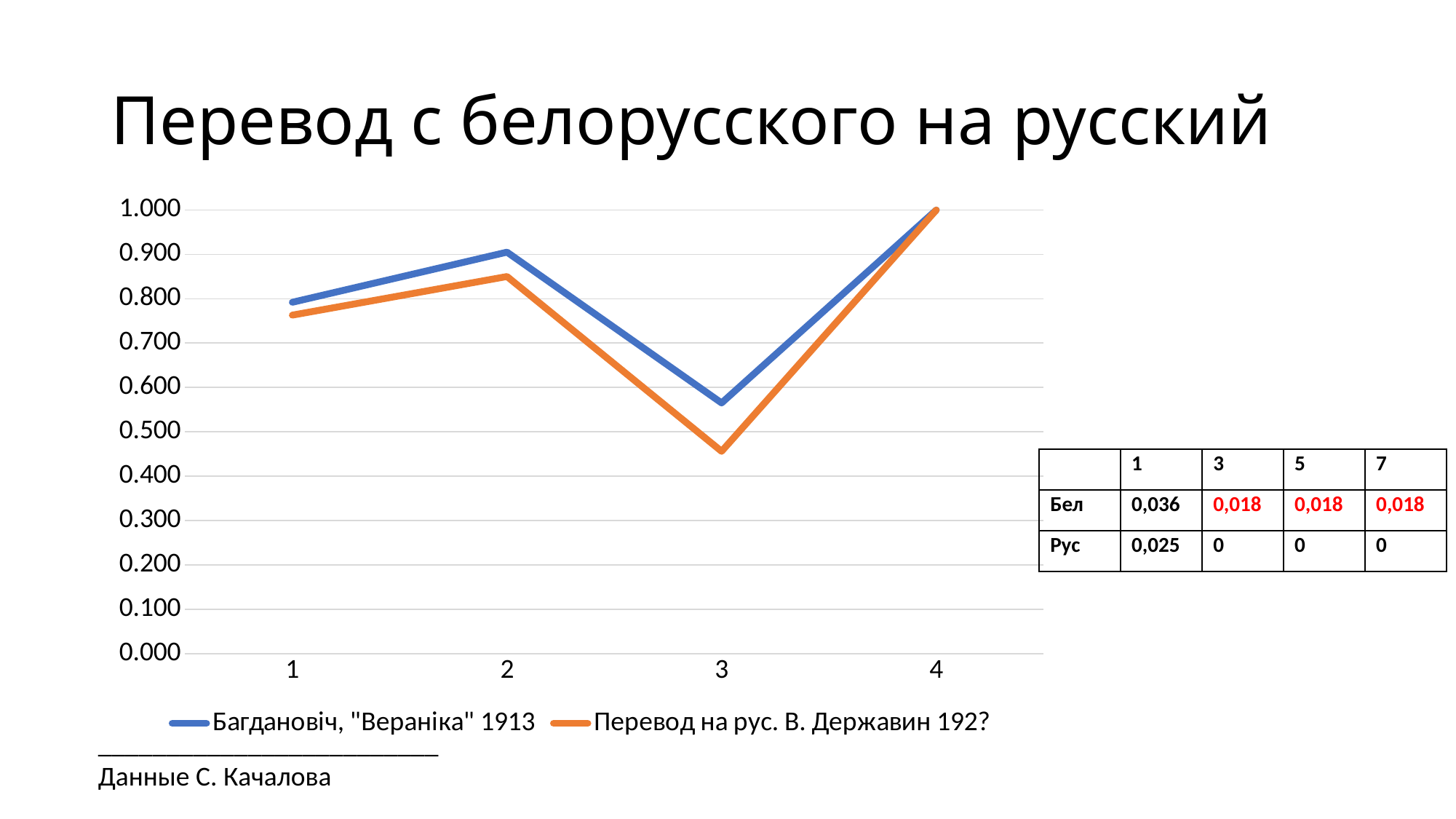
At point 3, which series has the larger value? Багдановіч, "Вераніка" 1913 How many series does the legend list? 2 At which x-axis point is the series Перевод на рус. В. Державин 192? highest? 4 Is the value for Перевод на рус. В. Державин 192? at point 3 greater or less than 0.500? less At which x-axis point is the series Багдановіч, "Вераніка" 1913 lowest? 3 What is the title of the slide containing the chart? Перевод с белорусского на русский How many points are plotted along the x axis for each series? 4 What kind of chart is shown on the slide? line chart Do the values of both series rise or fall from point 3 to point 4? rise Is the value for Багдановіч, "Вераніка" 1913 at point 3 greater or less than 0.500? greater What is the value of the series Перевод на рус. В. Державин 192? at point 4? 1.000 What is the value of the series Багдановіч, "Вераніка" 1913 at point 4? 1.000